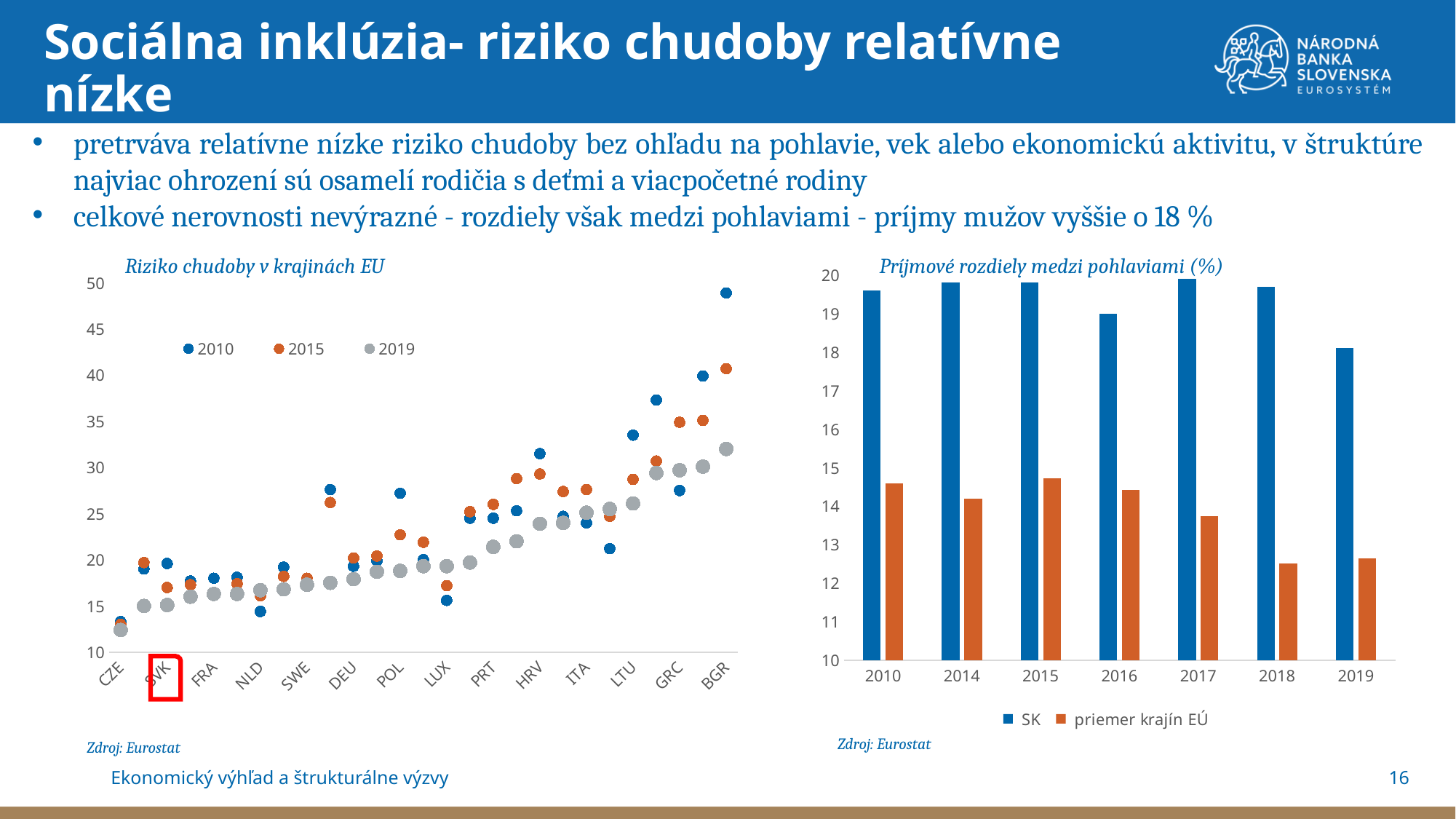
In the right-hand chart 'Príjmové rozdiely medzi pohlaviami (%)', how many series does the legend list? 2 What are the legend entries of the left-hand chart 'Riziko chudoby v krajinách EU'? 2010, 2015, 2019 In the right-hand chart 'Príjmové rozdiely medzi pohlaviami (%)', in which year is the SK bar lowest? 2019 In the left-hand chart 'Riziko chudoby v krajinách EU', is the 2010 value for BGR greater or less than 45? greater In the right-hand chart 'Príjmové rozdiely medzi pohlaviami (%)', do the 'priemer krajín EÚ' values rise or fall from 2015 to 2019? fall What kind of chart is the right-hand chart, 'Príjmové rozdiely medzi pohlaviami (%)'? bar chart In the right-hand chart 'Príjmové rozdiely medzi pohlaviami (%)', how many years are shown on the x axis? 7 In the right-hand chart 'Príjmové rozdiely medzi pohlaviami (%)', is the SK value for 2019 greater or less than 19? less In the right-hand chart 'Príjmové rozdiely medzi pohlaviami (%)', is the 'priemer krajín EÚ' value for 2018 greater or less than 13? less In the left-hand chart 'Riziko chudoby v krajinách EU', how many series does the legend list? 3 In the left-hand chart 'Riziko chudoby v krajinách EU', which country has the highest 2010 value? BGR In the right-hand chart 'Príjmové rozdiely medzi pohlaviami (%)', which is larger in 2017: SK or priemer krajín EÚ? SK